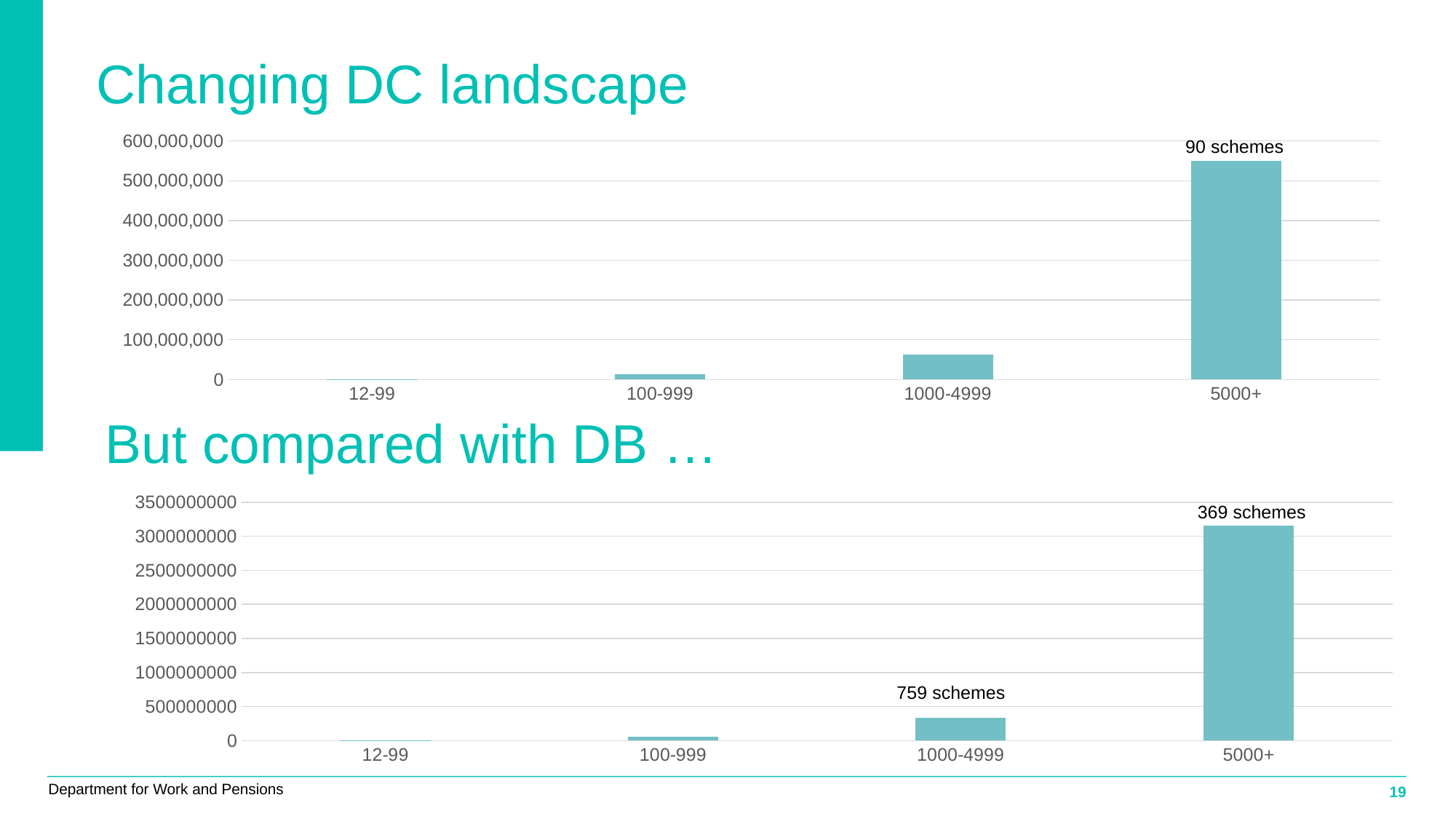
In the top chart (Changing DC landscape), what label is printed above the 5000+ bar? 90 schemes In the top chart (Changing DC landscape), do the values rise or fall moving from 12-99 to 5000+ along the x axis? rise In the top chart (Changing DC landscape), how many categories are shown on the x axis? 4 In the top chart (Changing DC landscape), which category has the highest value? 5000+ What type of chart is shown under the title 'Changing DC landscape'? bar chart In the bottom chart (But compared with DB …), which category has the highest value? 5000+ In the top chart (Changing DC landscape), is the value for 1000-4999 greater or less than 100,000,000? less In the top chart (Changing DC landscape), is the value for 5000+ greater or less than 500,000,000? greater In the bottom chart (But compared with DB …), what label is printed above the 1000-4999 bar? 759 schemes In the bottom chart (But compared with DB …), is the value for 5000+ greater or less than 3000000000? greater In the top chart (Changing DC landscape), which category has the lowest value? 12-99